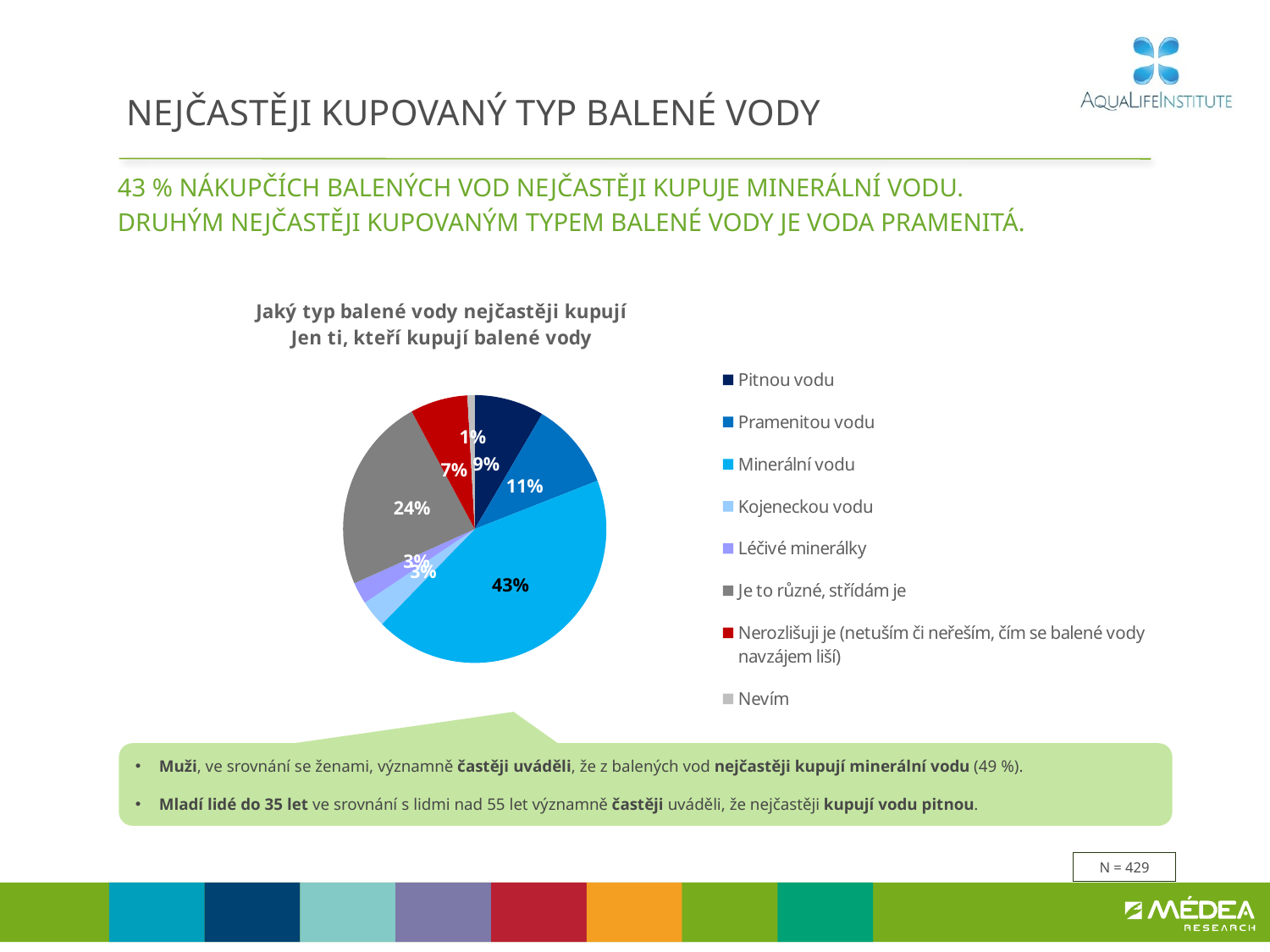
What share of the pie is labelled for "Minerální vodu"? 43% Which category has the largest slice of the pie? Minerální vodu What type of chart is shown on the slide? pie chart What share of the pie is labelled for "Je to různé, střídám je"? 24% What is the difference in percentage points between the "Minerální vodu" slice and the "Je to různé, střídám je" slice? 19 What share of the pie is labelled for "Pramenitou vodu"? 11% What is the title of the chart? Jaký typ balené vody nejčastěji kupují Jen ti, kteří kupují balené vody How many entries does the legend list? 8 Which slice is larger, "Pramenitou vodu" or "Pitnou vodu"? Pramenitou vodu What share of the pie is labelled for "Nerozlišuji je (netuším či neřeším, čím se balené vody navzájem liší)"? 7% Which category has the smallest slice of the pie? Nevím What share of the pie is labelled for "Pitnou vodu"? 9%